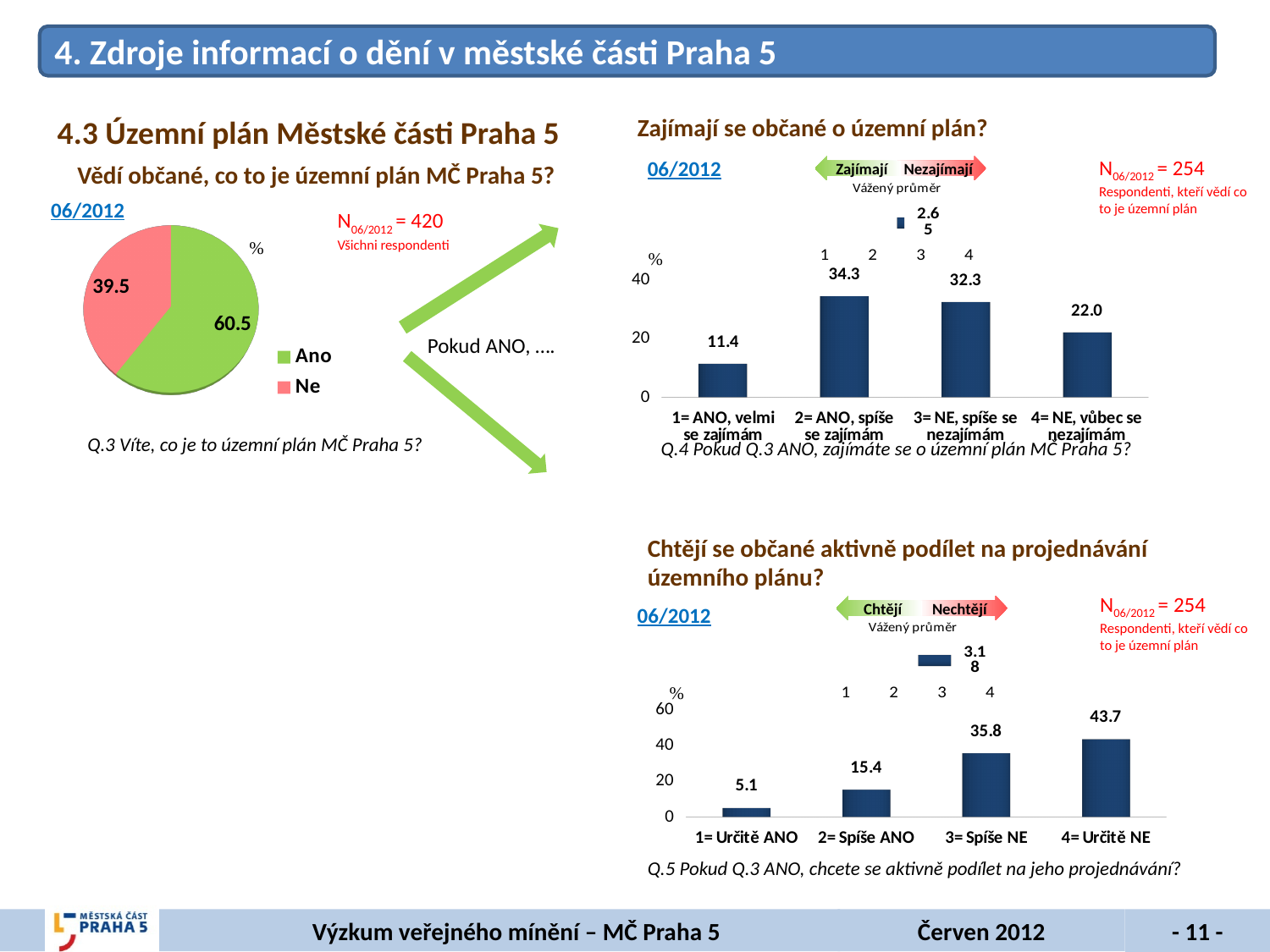
In the chart 'Chtějí se občané aktivně podílet na projednávání územního plánu?', which category has the highest value? 4= Určitě NE What kind of chart is the chart on the left of the slide, under 'Vědí občané, co to je územní plán MČ Praha 5?'? pie chart In the chart 'Chtějí se občané aktivně podílet na projednávání územního plánu?', what is the difference between the values for '3= Spíše NE' and '2= Spíše ANO'? 20.4 In the chart 'Chtějí se občané aktivně podílet na projednávání územního plánu?', do the values rise or fall from category 1 to category 4? rise In the chart 'Zajímají se občané o územní plán?', what is the value for '2= ANO, spíše se zajímám'? 34.3 In the chart 'Zajímají se občané o územní plán?', which category has the lowest value? 1= ANO, velmi se zajímám In the chart 'Zajímají se občané o územní plán?', what is the weighted average (Vážený průměr) shown? 2.65 In the chart 'Zajímají se občané o územní plán?', what is the difference between the values for '3= NE, spíše se nezajímám' and '4= NE, vůbec se nezajímám'? 10.3 In the pie chart 'Vědí občané, co to je územní plán MČ Praha 5?', what is the value for 'Ne'? 39.5 In the pie chart 'Vědí občané, co to je územní plán MČ Praha 5?', what is the value for 'Ano'? 60.5 In the chart 'Chtějí se občané aktivně podílet na projednávání územního plánu?', what is the value for '1= Určitě ANO'? 5.1 In the pie chart on the left, how many slices are there? 2